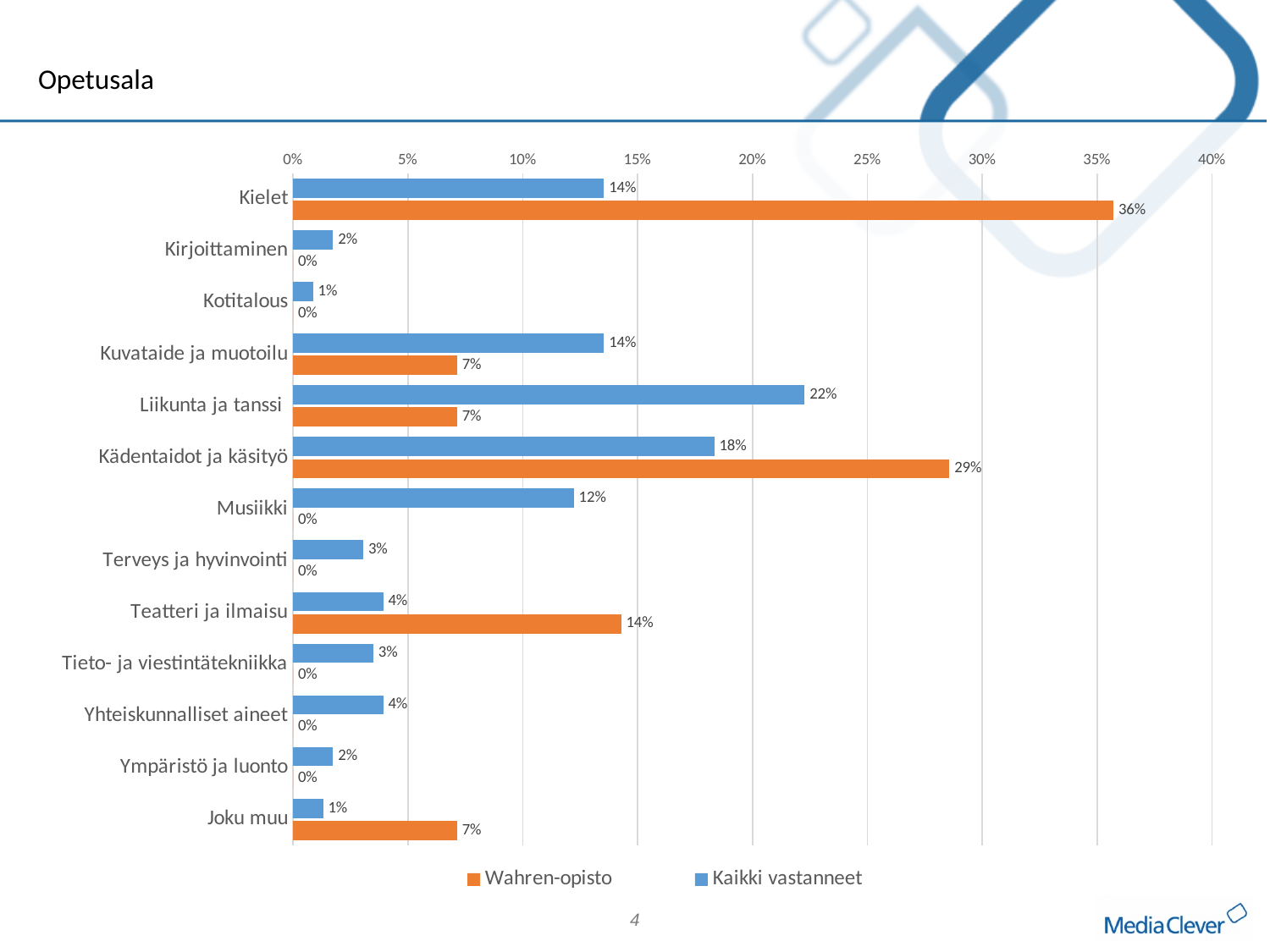
Which category has the highest value for Kaikki vastanneet? Liikunta ja tanssi Which category has the highest value for Wahren-opisto? Kielet What is the value for Kaikki vastanneet in the Musiikki category? 12% What is the difference between the Wahren-opisto and Kaikki vastanneet values for Kädentaidot ja käsityö? 11% What is the value for Wahren-opisto in the Kielet category? 36% What kind of chart is shown on the slide? Bar chart How many series does the legend list? 2 For Kuvataide ja muotoilu, which series has the larger value, Wahren-opisto or Kaikki vastanneet? Kaikki vastanneet What is the value for Kaikki vastanneet in the Liikunta ja tanssi category? 22% How many categories are shown on the chart? 13 What is the value for Wahren-opisto in the Teatteri ja ilmaisu category? 14% Which colour represents the Wahren-opisto series? Orange